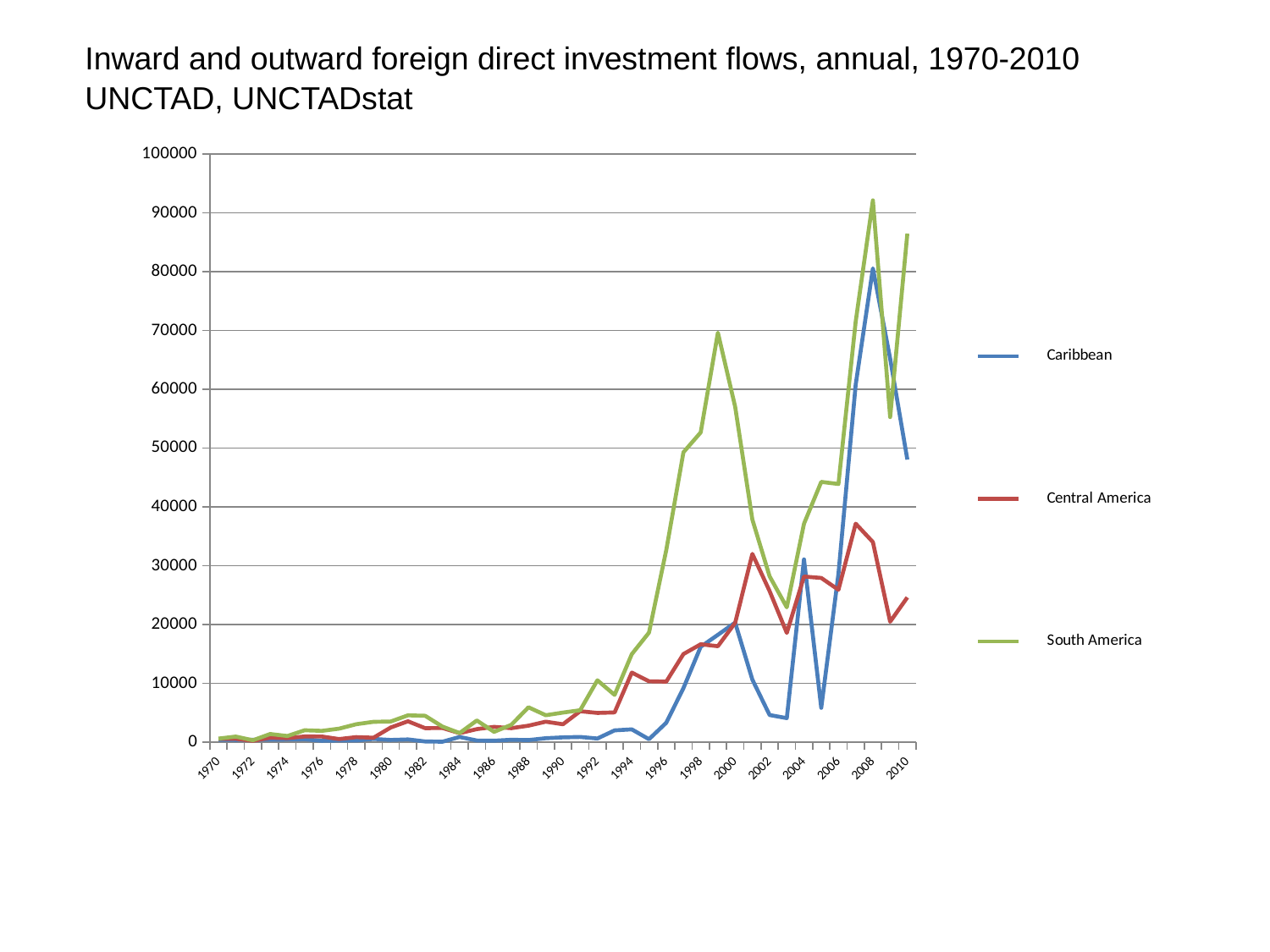
Is the value for Central America in 2010 greater or less than 20000? greater Which colour is used for the Central America line? red Which series reaches the highest value anywhere on the chart? South America Is the value for South America in 1999 greater or less than 60000? greater Is the value for South America in 2008 greater or less than 80000? greater In 2010, which is larger: the value for South America or the value for Caribbean? South America What kind of chart is shown on the slide? line chart Which series has the lowest value in 2005? Caribbean How many series does the legend list? 3 Does the South America line rise or fall between 1999 and 2002? fall In 2005, which is larger: the value for Central America or the value for Caribbean? Central America